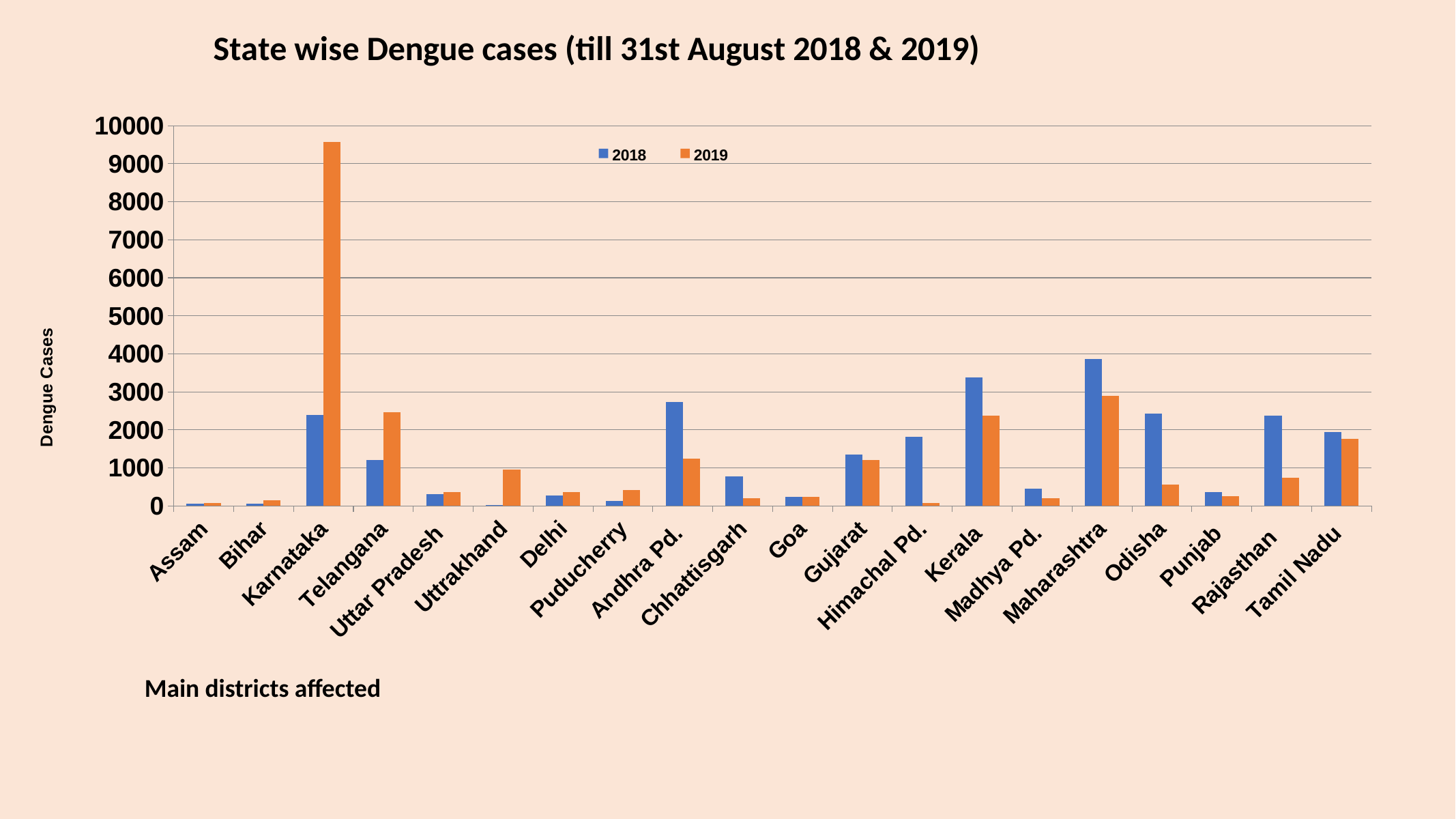
Is the 2019 value for Odisha greater or less than 1000? less How many states are shown on the x axis? 20 What kind of chart is shown on the slide? bar chart Is the 2018 value for Maharashtra greater or less than 4000? less How many series does the legend list? 2 For Andhra Pd., which year has more dengue cases, 2018 or 2019? 2018 For Telangana, which year has more dengue cases, 2018 or 2019? 2019 What is the title of the chart? State wise Dengue cases (till 31st August 2018 & 2019) Which state has the highest number of dengue cases in 2018? Maharashtra Which state has the highest number of dengue cases in 2019? Karnataka Is the 2019 value for Karnataka greater or less than 9000? greater